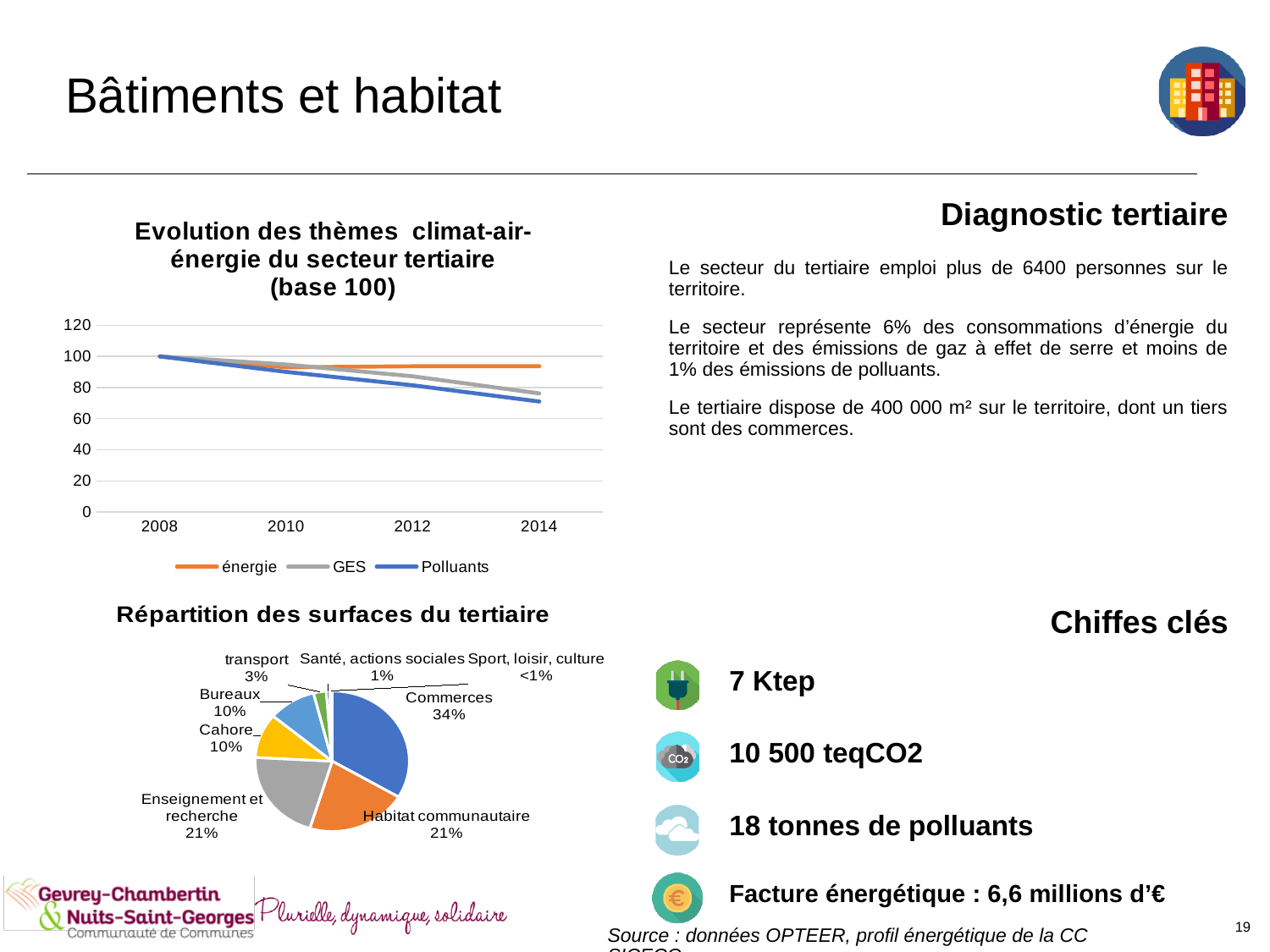
In the 'Evolution des thèmes climat-air-énergie du secteur tertiaire' chart, what is the value of all three series in 2008? 100 What kind of chart is the 'Evolution des thèmes climat-air-énergie du secteur tertiaire (base 100)' chart? line chart How many categories are shown in the 'Répartition des surfaces du tertiaire' pie chart? 8 In the 'Evolution des thèmes climat-air-énergie du secteur tertiaire' chart, do the values for Polluants rise or fall from 2008 to 2014? fall How many series does the legend of the 'Evolution des thèmes climat-air-énergie du secteur tertiaire' chart list? 3 In the 'Répartition des surfaces du tertiaire' pie chart, what share do Commerces represent? 34% In the 'Répartition des surfaces du tertiaire' pie chart, which category has the largest share? Commerces What kind of chart is 'Répartition des surfaces du tertiaire'? pie chart In the 'Répartition des surfaces du tertiaire' pie chart, what is the difference between the share of Commerces and the share of Habitat communautaire? 13% In the 'Evolution des thèmes climat-air-énergie du secteur tertiaire' chart, is the value for énergie in 2014 greater or less than 80? greater In the 'Evolution des thèmes climat-air-énergie du secteur tertiaire' chart, which series has the lowest value in 2014? Polluants In the 'Evolution des thèmes climat-air-énergie du secteur tertiaire' chart, is the value for Polluants in 2014 greater or less than 80? less